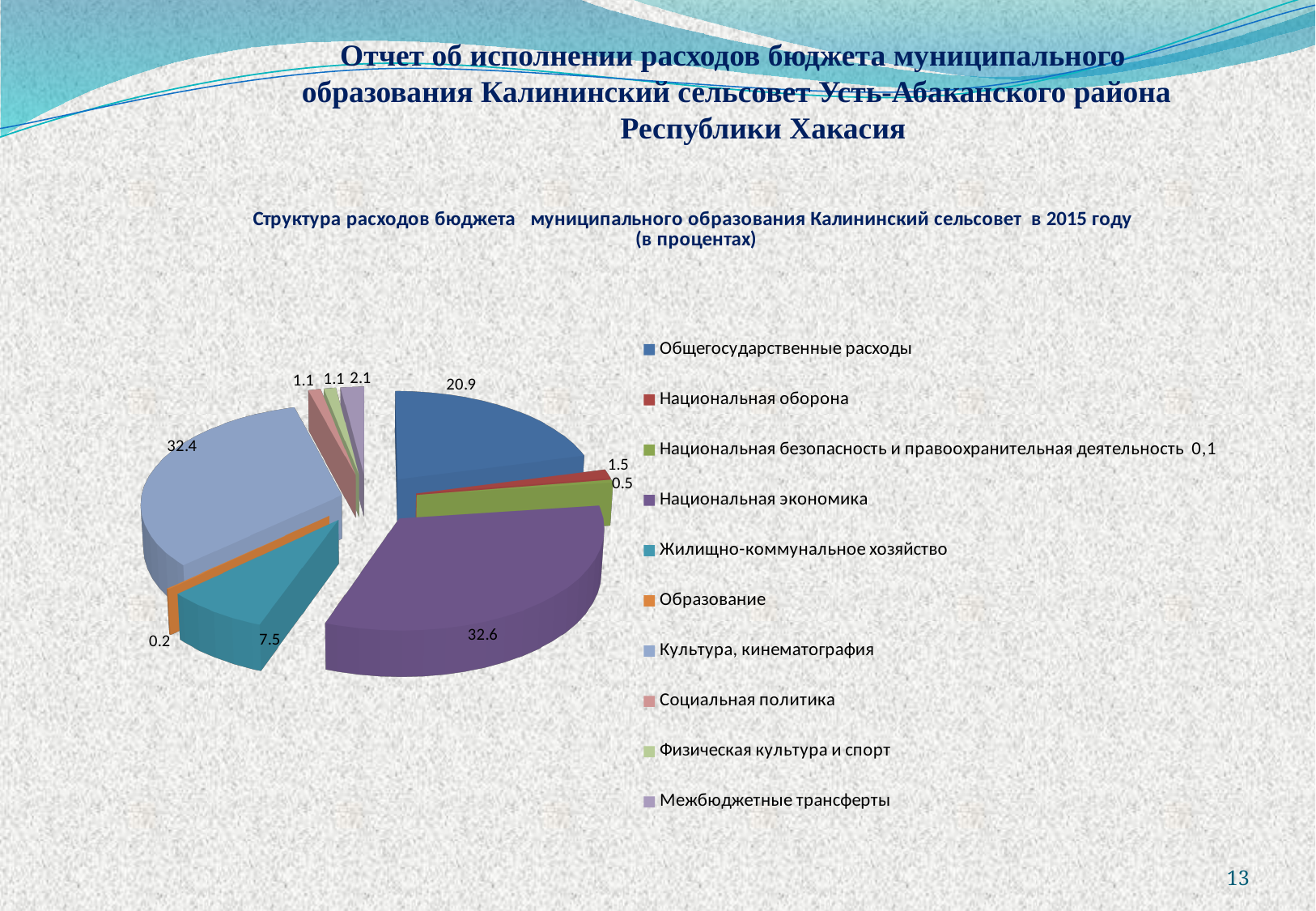
What is the value for Национальная экономика? 32.6 What is the value for Жилищно-коммунальное хозяйство? 7.5 What is the difference between the values for Национальная экономика and Общегосударственные расходы? 11.7 What is the value for Общегосударственные расходы? 20.9 What year does the chart title say the budget expenditure structure refers to? 2015 What is the value for Межбюджетные трансферты? 2.1 Which category has the largest share of the pie? Национальная экономика Which is larger, Общегосударственные расходы or Жилищно-коммунальное хозяйство? Общегосударственные расходы Which category has the smallest share of the pie? Образование What type of chart is shown on the slide? Pie chart How many categories does the legend list? 10 What is the value for Культура, кинематография? 32.4